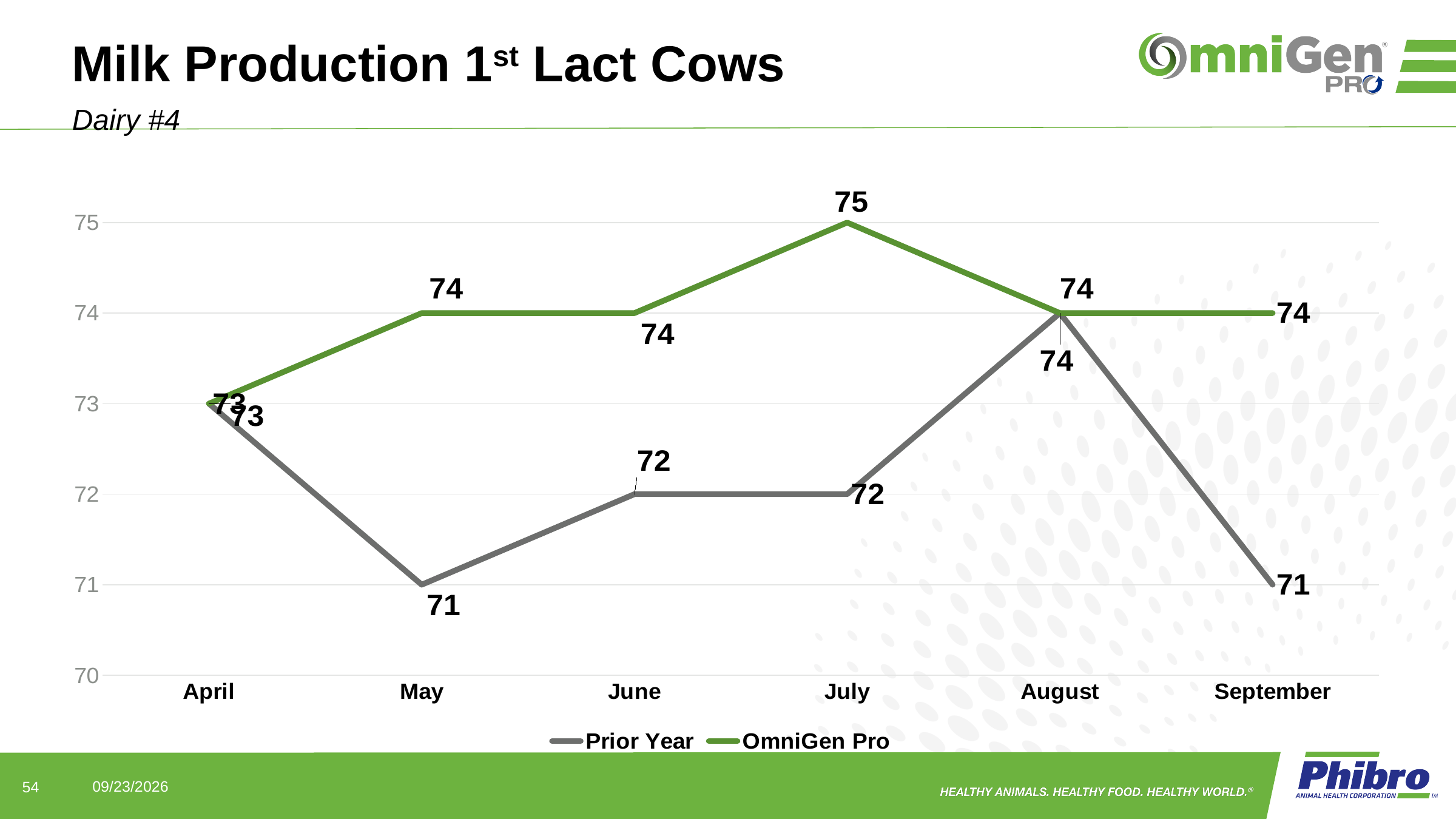
What is the Prior Year value for May? 71 Which series has the higher value in June, Prior Year or OmniGen Pro? OmniGen Pro What is the Prior Year value for August? 74 What is the OmniGen Pro value for July? 75 What kind of chart is shown on the slide? Line chart What is the OmniGen Pro value for September? 74 How many months are shown on the x axis? 6 How many series does the legend list? 2 What is the lowest value plotted for the Prior Year series? 71 What is the difference between the OmniGen Pro and Prior Year values in May? 3 Does the Prior Year series rise or fall from August to September? Fall In which month does the OmniGen Pro series reach its highest value? July